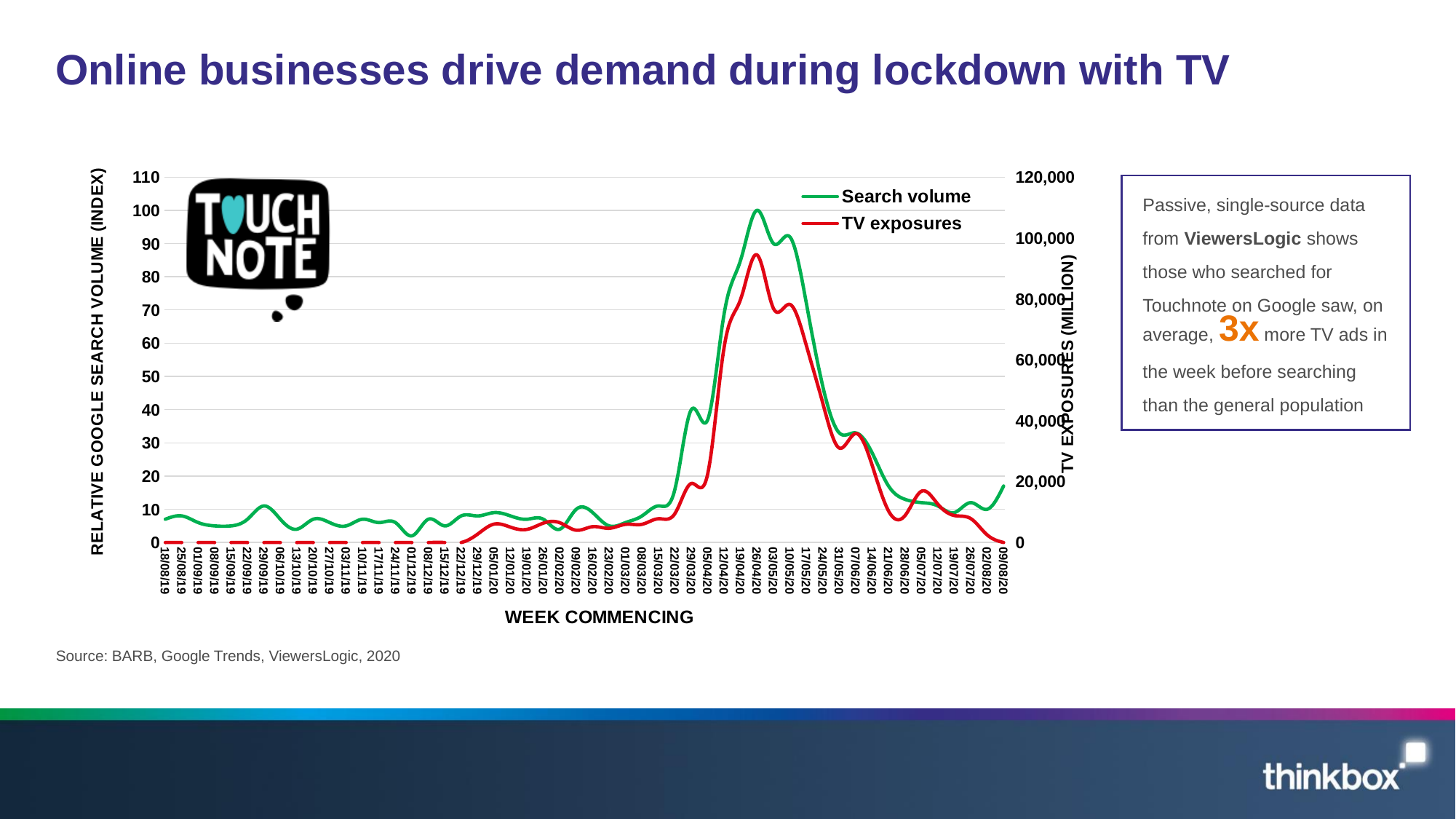
Is the Search volume value for the week commencing 10/05/20 greater or less than 80? greater What are the two series named in the chart's legend? Search volume and TV exposures Between the weeks commencing 26/04/20 and 21/06/20, does the TV exposures line rise or fall? fall How many series does the chart's legend list? 2 Between the weeks commencing 15/03/20 and 26/04/20, does the Search volume line rise or fall? rise What kind of chart is shown on the slide? Line chart In which week commencing does the Search volume line reach its highest point? 26/04/20 Is the Search volume value for the week commencing 18/08/19 greater or less than 20? less Is the TV exposures value for the week commencing 05/07/20 greater or less than 40,000? less What is the title of the chart's x axis? WEEK COMMENCING